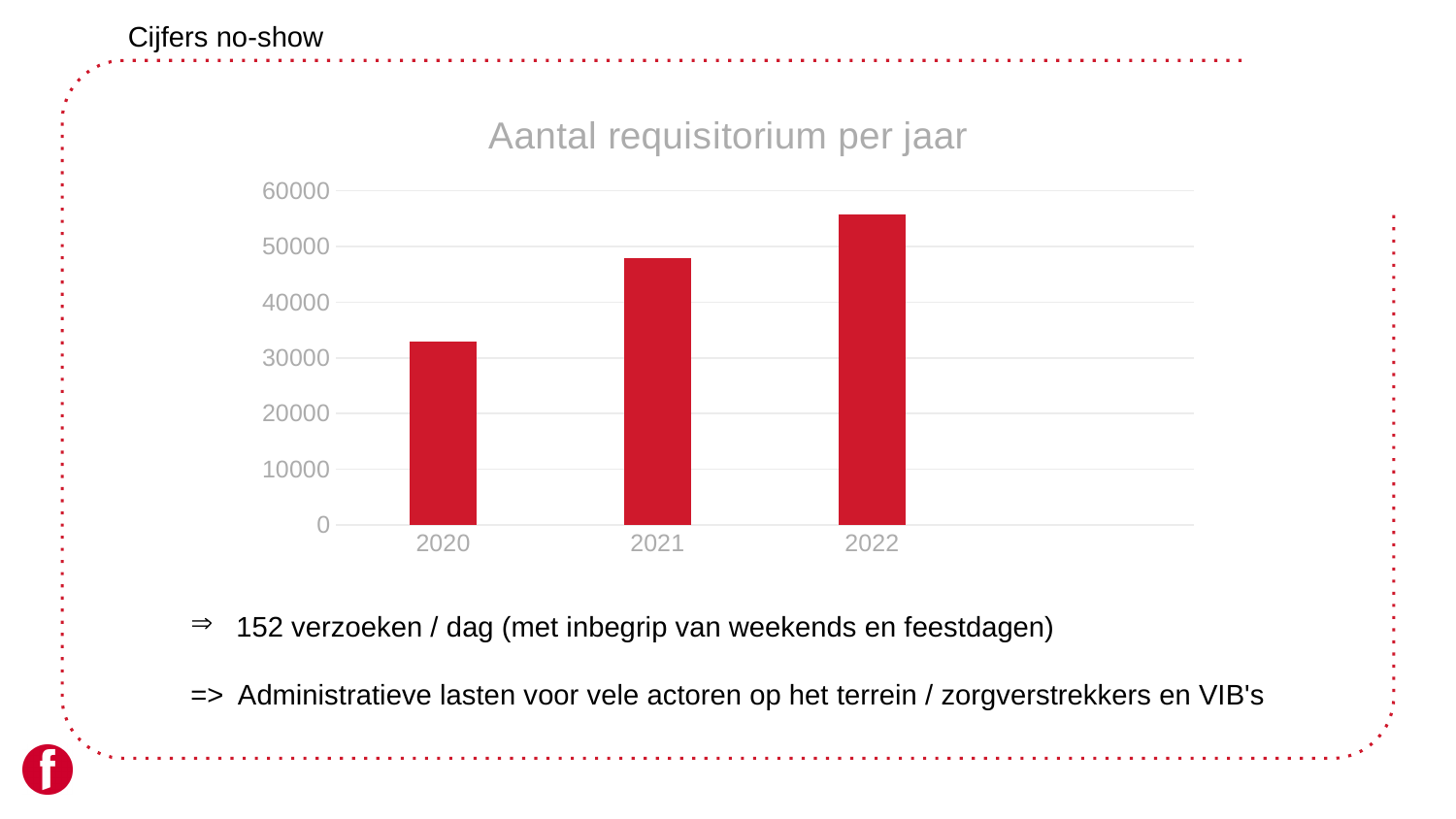
Is the value for 2022 greater or less than 50000? greater Do the values rise or fall from 2020 to 2022? rise How many years are shown on the x axis of the chart? 3 What is the title of the chart? Aantal requisitorium per jaar Is the value for 2021 greater or less than 40000? greater Which year has the highest number of requisitorium? 2022 Is the value for 2020 greater or less than 30000? greater What colour are the bars in the chart? red Which year has the lowest number of requisitorium? 2020 Which is larger, the value for 2021 or the value for 2022? 2022 What kind of chart is shown on the slide? bar chart